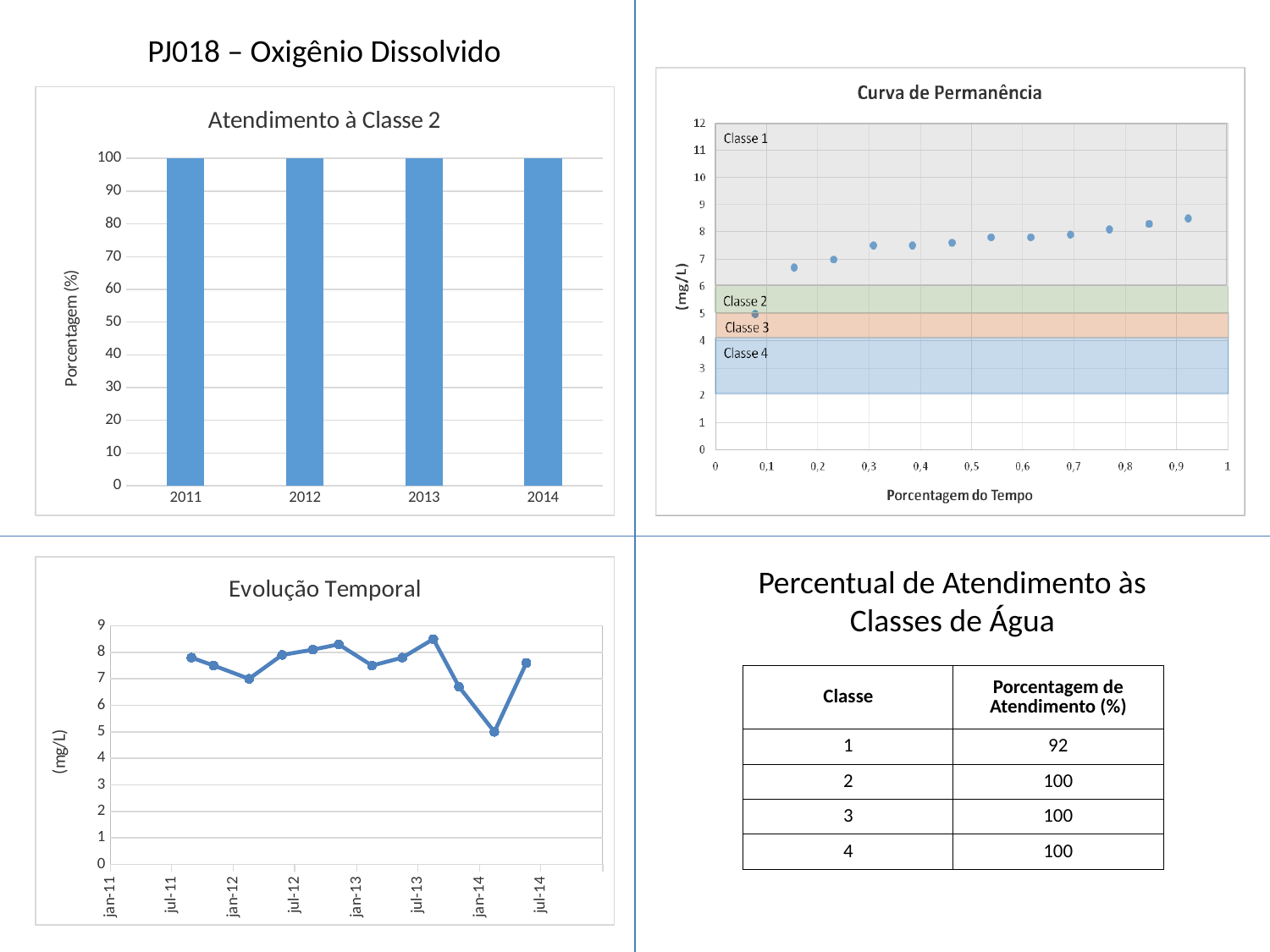
In the 'Atendimento à Classe 2' chart, what is the value for 2014? 100 What kind of chart is 'Atendimento à Classe 2'? bar chart What is the x-axis label of the 'Curva de Permanência' chart? Porcentagem do Tempo How many years are shown in the 'Atendimento à Classe 2' chart? 4 In the 'Evolução Temporal' chart, is the lowest value greater or less than 6? less In the 'Atendimento à Classe 2' chart, what is the difference between the values for 2011 and 2013? 0 What kind of chart is 'Evolução Temporal'? line chart In the 'Curva de Permanência' chart, do the values rise or fall as the percentage of time increases? rise In the 'Curva de Permanência' chart, is the value of the rightmost point greater or less than 8? greater In the 'Curva de Permanência' chart, is the value of the leftmost point greater or less than 6? less In the 'Atendimento à Classe 2' chart, what is the value for 2012? 100 What is the y-axis label of the 'Atendimento à Classe 2' chart? Porcentagem (%)